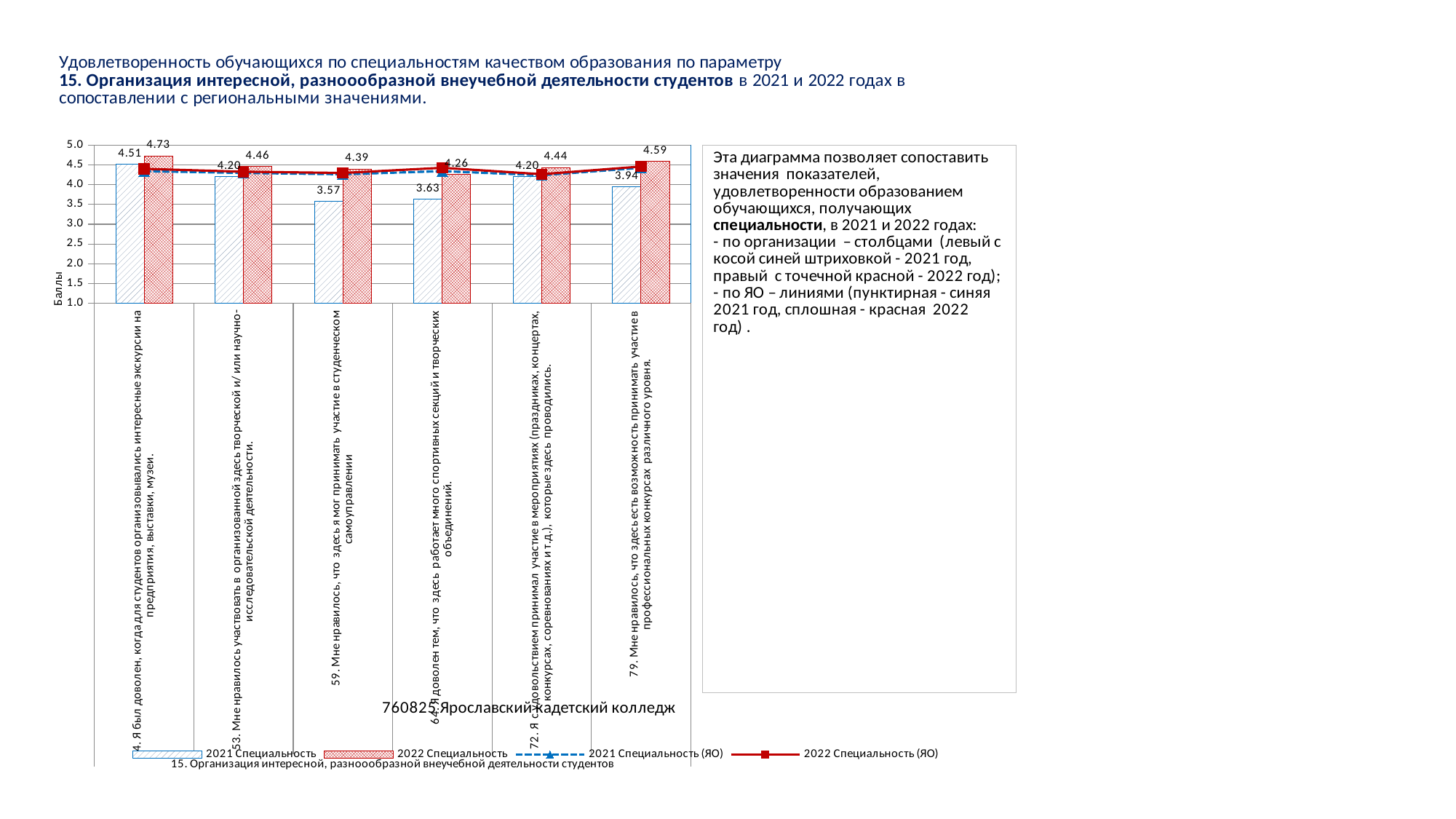
How many items (categories) are shown on the x axis of the chart? 6 What is the value of the 2022 Специальность bar for item 4 (excursions to enterprises, exhibitions, museums)? 4.73 Which item has the lowest 2021 Специальность bar? 59. Мне нравилось, что здесь я мог принимать участие в студенческом самоуправлении What is the difference between the 2022 and 2021 Специальность bars for item 59 (student self-government)? 0.82 What is the label of the vertical axis of the chart? Баллы How many series does the chart legend list? 4 Is the 2021 Специальность value for item 79 (professional competitions) greater or less than 4.0? less For item 64 (sports sections and creative associations), which bar is larger: 2021 Специальность or 2022 Специальность? 2022 Специальность What is the value of the 2021 Специальность bar for item 59 (participation in student self-government)? 3.57 What is the value of the 2022 Специальность bar for item 79 (professional competitions of various levels)? 4.59 Which item has the highest 2022 Специальность bar? 4. Я был доволен, когда для студентов организовывались интересные экскурсии на предприятия, выставки, музеи. What kind of chart is shown on the slide? Combined bar and line chart